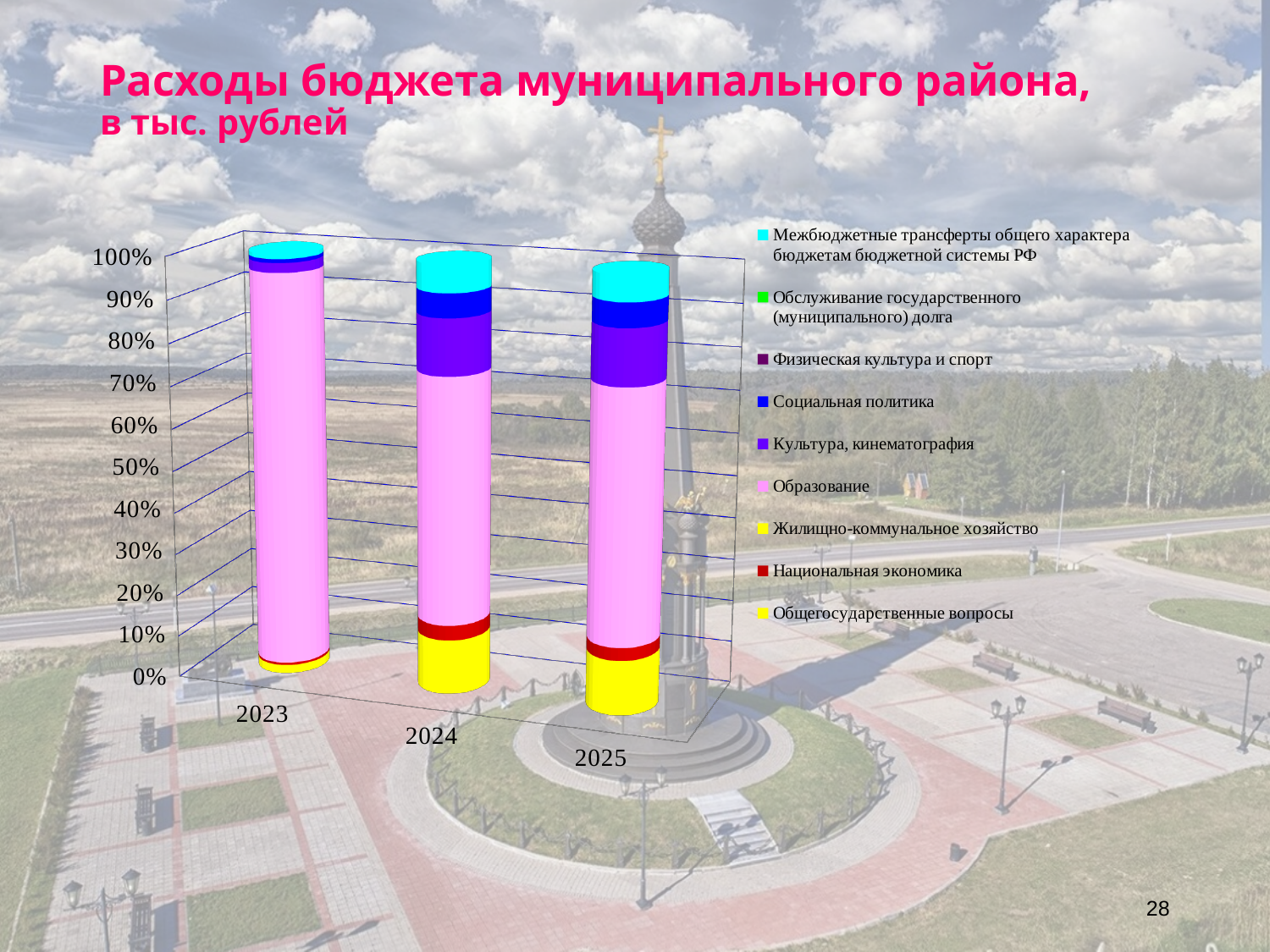
Is the share of Национальная экономика in 2025 greater or less than 20%? less Which series in the legend is shown in pink? Образование Which year has the larger share of Образование, 2023 or 2025? 2023 What kind of chart is shown on the slide? Stacked bar chart Which years are shown as categories on the x axis? 2023, 2024, 2025 Is the share of Образование in 2024 greater or less than 40%? greater How many years (categories) are shown on the x axis of the chart? 3 What is the title of the slide containing the chart? Расходы бюджета муниципального района, в тыс. рублей Does the share of Образование rise or fall from 2023 to 2025? fall Is the share of Образование in 2023 greater or less than 50%? greater Does the share of Культура, кинематография rise or fall from 2023 to 2025? rise How many series does the chart legend list? 9